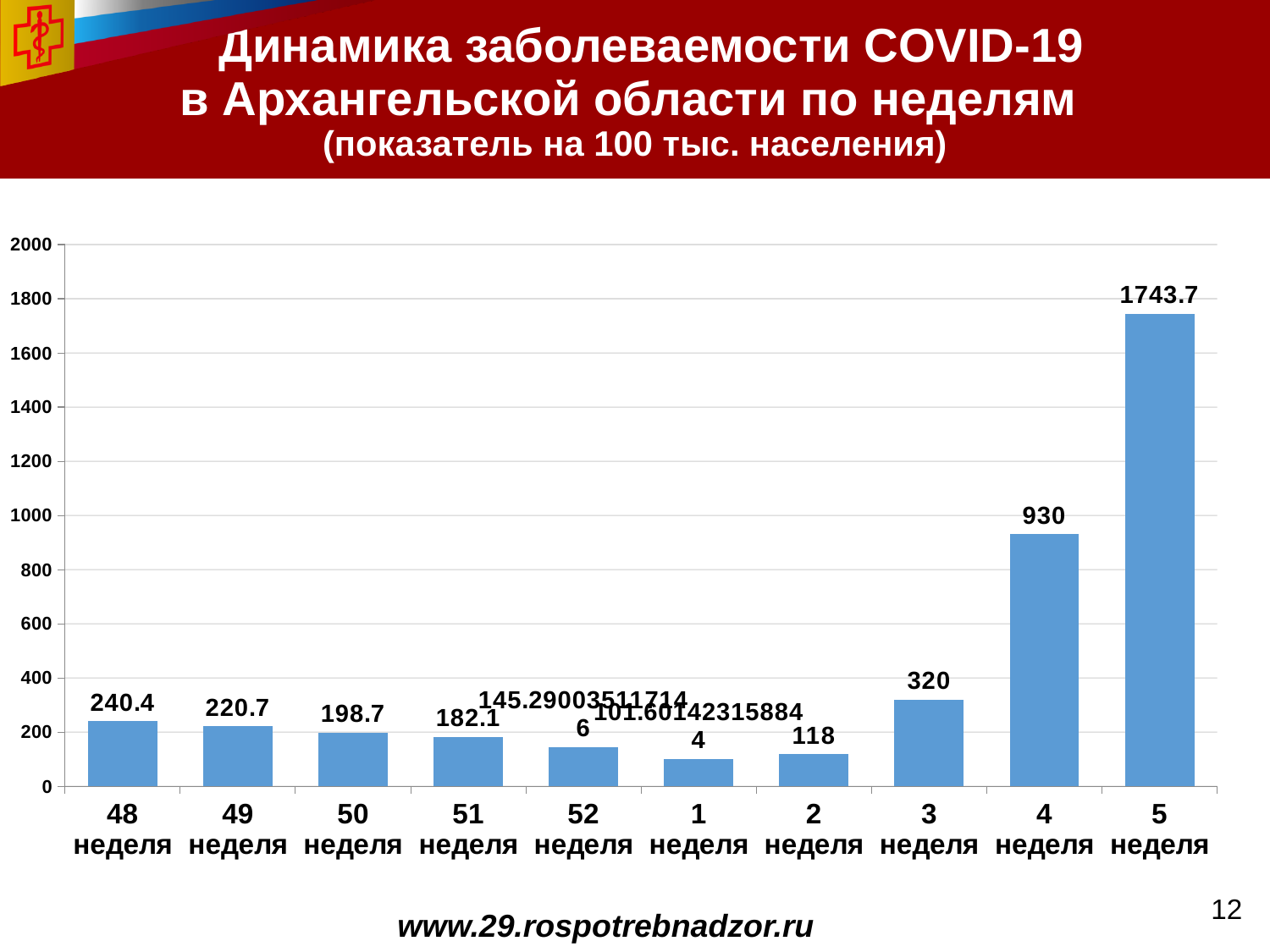
What is the value for 3 неделя? 320 What is the value for 4 неделя? 930 Which is larger, the value for 3 неделя or 2 неделя? 3 неделя What is the value for 48 неделя? 240.4 Is the value for 52 неделя greater or less than 200? less What is the value for 5 неделя? 1743.7 What is the difference between the values for 48 неделя and 49 неделя? 19.7 What is the difference between the values for 5 неделя and 4 неделя? 813.7 What kind of chart is shown on the slide? bar chart Which week has the highest value? 5 неделя Do the values rise or fall from 48 неделя to 51 неделя? fall How many weeks are shown on the x axis? 10